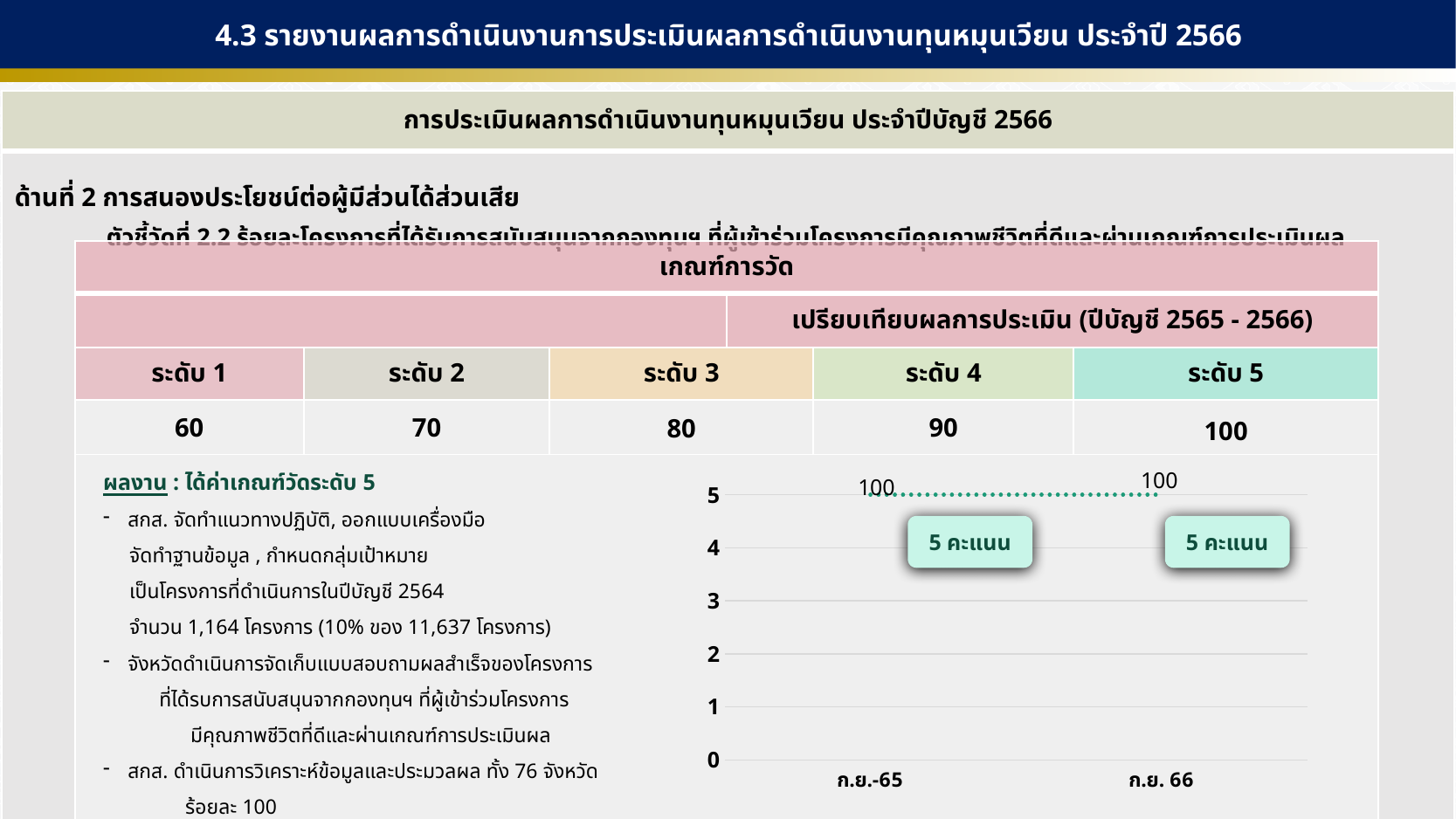
What is the difference between the labelled values for ก.ย.-65 and ก.ย. 66? 0 Is the plotted point for ก.ย.-65 greater or less than 3 on the y axis? greater Which is larger, the value for ก.ย.-65 or the value for ก.ย. 66? they are equal At which y-axis level do both plotted points sit? 5 What is the highest tick value shown on the y axis of the chart? 5 How many data points are plotted on the chart? 2 What kind of chart is shown on the slide? line chart What score is shown in the callout box under each data point? 5 คะแนน Do the values rise, fall, or stay the same from ก.ย.-65 to ก.ย. 66? stay the same What data label is shown for ก.ย. 66 on the chart? 100 What data label is shown for ก.ย.-65 on the chart? 100